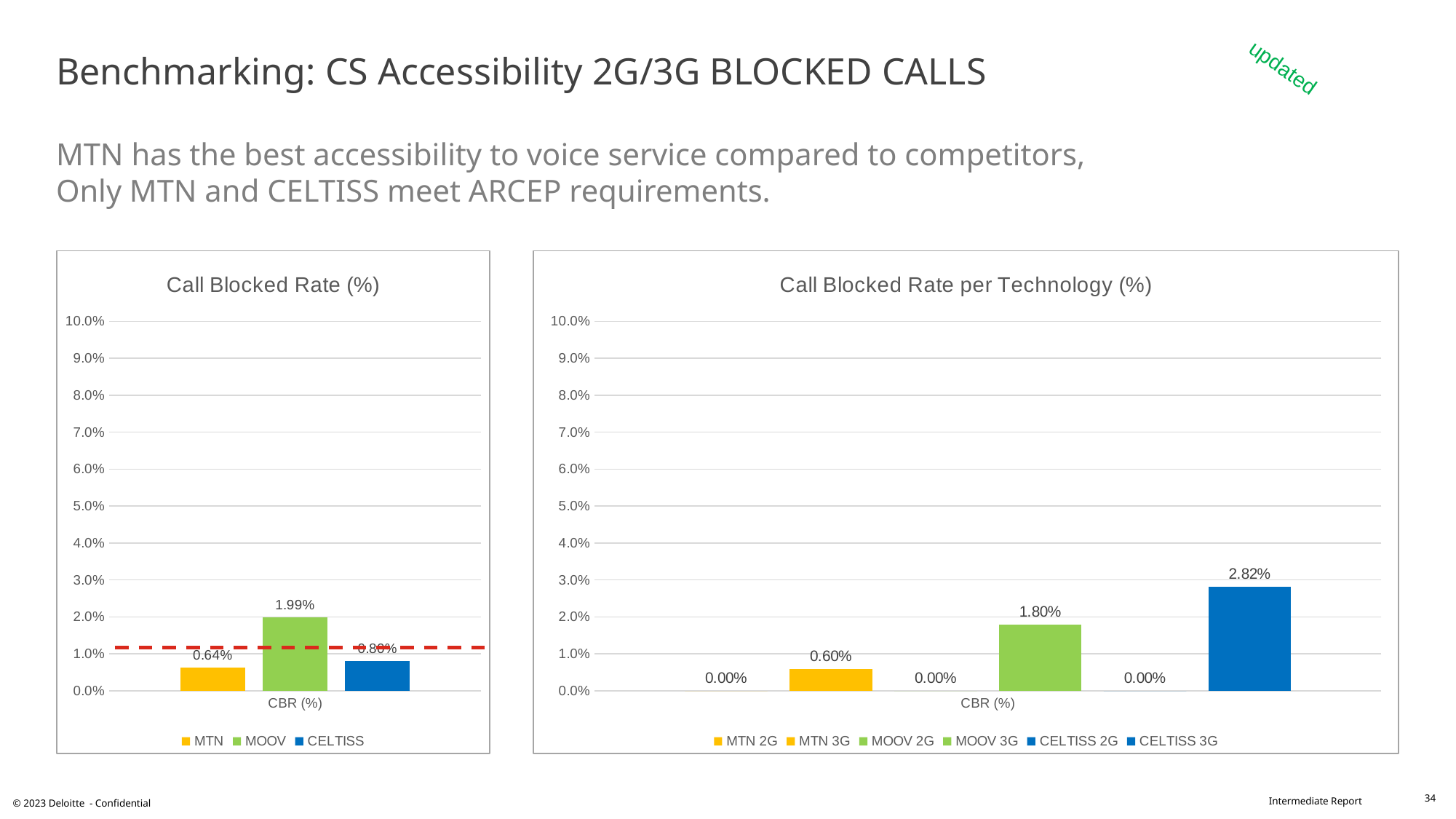
In the Call Blocked Rate (%) chart, which operator has the highest call blocked rate? MOOV In the Call Blocked Rate per Technology (%) chart, what is the difference between the CELTISS 3G and MOOV 3G values? 1.02% How many series does the legend of the Call Blocked Rate per Technology (%) chart list? 6 In the Call Blocked Rate (%) chart, what is the difference between the MOOV and MTN values? 1.35% In the Call Blocked Rate per Technology (%) chart, which series has the highest value? CELTISS 3G In the Call Blocked Rate (%) chart, which operator has the lowest call blocked rate? MTN How many series does the legend of the Call Blocked Rate (%) chart list? 3 In the Call Blocked Rate per Technology (%) chart, what is the value for CELTISS 3G? 2.82% In the Call Blocked Rate per Technology (%) chart, what is the value for MOOV 3G? 1.80% In the Call Blocked Rate (%) chart, what is the value for MTN? 0.64% In the Call Blocked Rate (%) chart, what is the value for MOOV? 1.99% In the Call Blocked Rate per Technology (%) chart, what is the value for MTN 3G? 0.60%